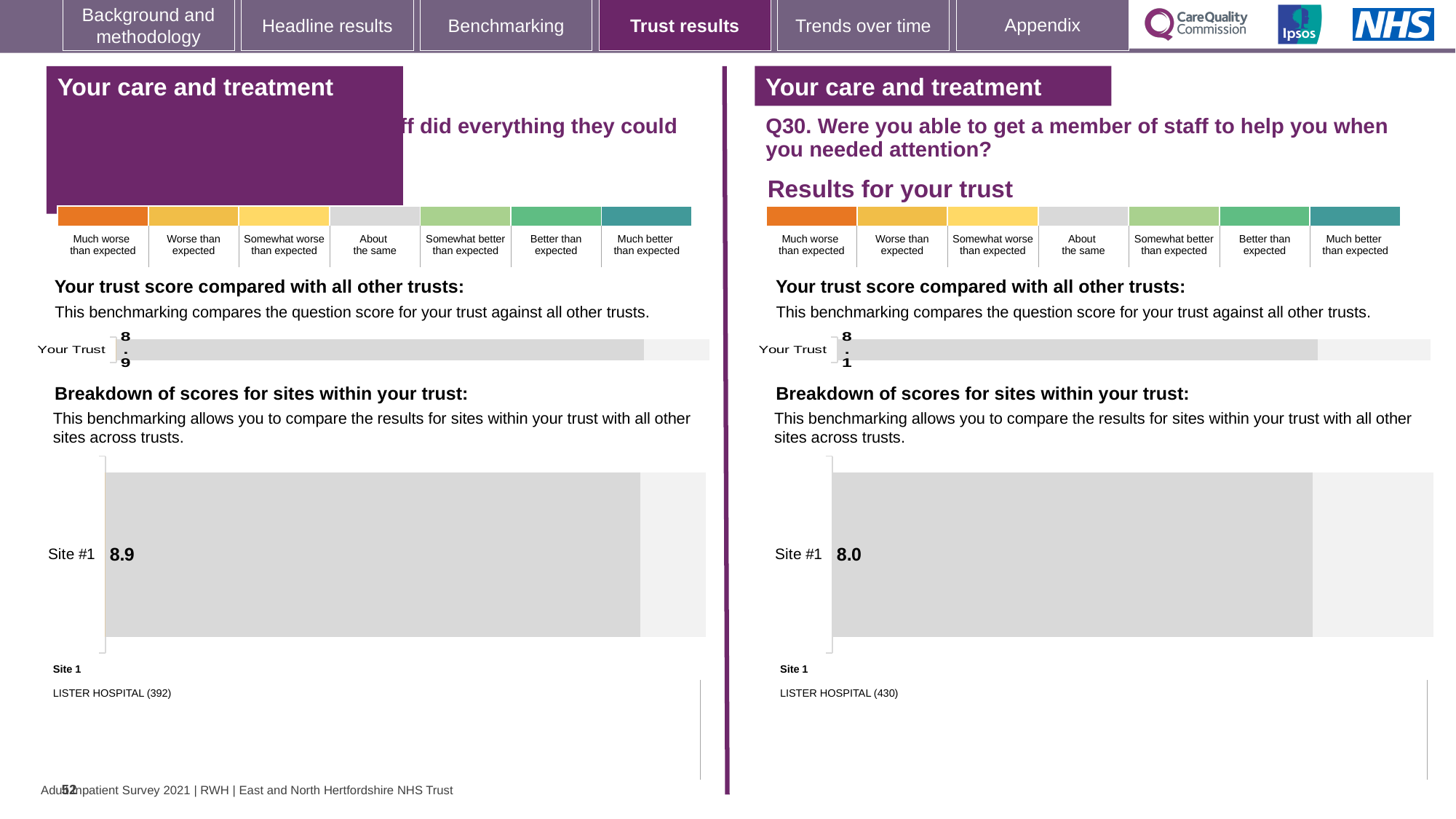
What kind of chart is used to show the Site #1 score on the left half of the slide? Bar chart How many rating categories are shown in the colour scale above the Q30 chart, from 'Much worse than expected' to 'Much better than expected'? 7 On the right half of the slide (Q30), what is the score shown for Your Trust in the 'Your trust score compared with all other trusts' chart? 8.1 Which is larger: the Site #1 score in the left-hand site breakdown chart or the Site #1 score in the right-hand (Q30) site breakdown chart? The left-hand chart (8.9) In the 'Breakdown of scores for sites within your trust' chart for Q30 on the right half of the slide, what is the score for Site #1? 8.0 Is the Site #1 score in the right-hand (Q30) site breakdown chart greater or less than 8.5? less On the left half of the slide, what is the difference between the Your Trust score and the Site #1 score? 0 In the 'Breakdown of scores for sites within your trust' chart on the left half of the slide, what is the score for Site #1? 8.9 Which hospital is listed as Site 1 under the Q30 site breakdown chart on the right half of the slide? LISTER HOSPITAL (430) On the left half of the slide, what is the score shown for Your Trust in the 'Your trust score compared with all other trusts' chart? 8.9 How many sites are plotted in the 'Breakdown of scores for sites within your trust' chart on the right half of the slide (Q30)? 1 On the right half of the slide (Q30), what is the difference between the Your Trust score and the Site #1 score? 0.1